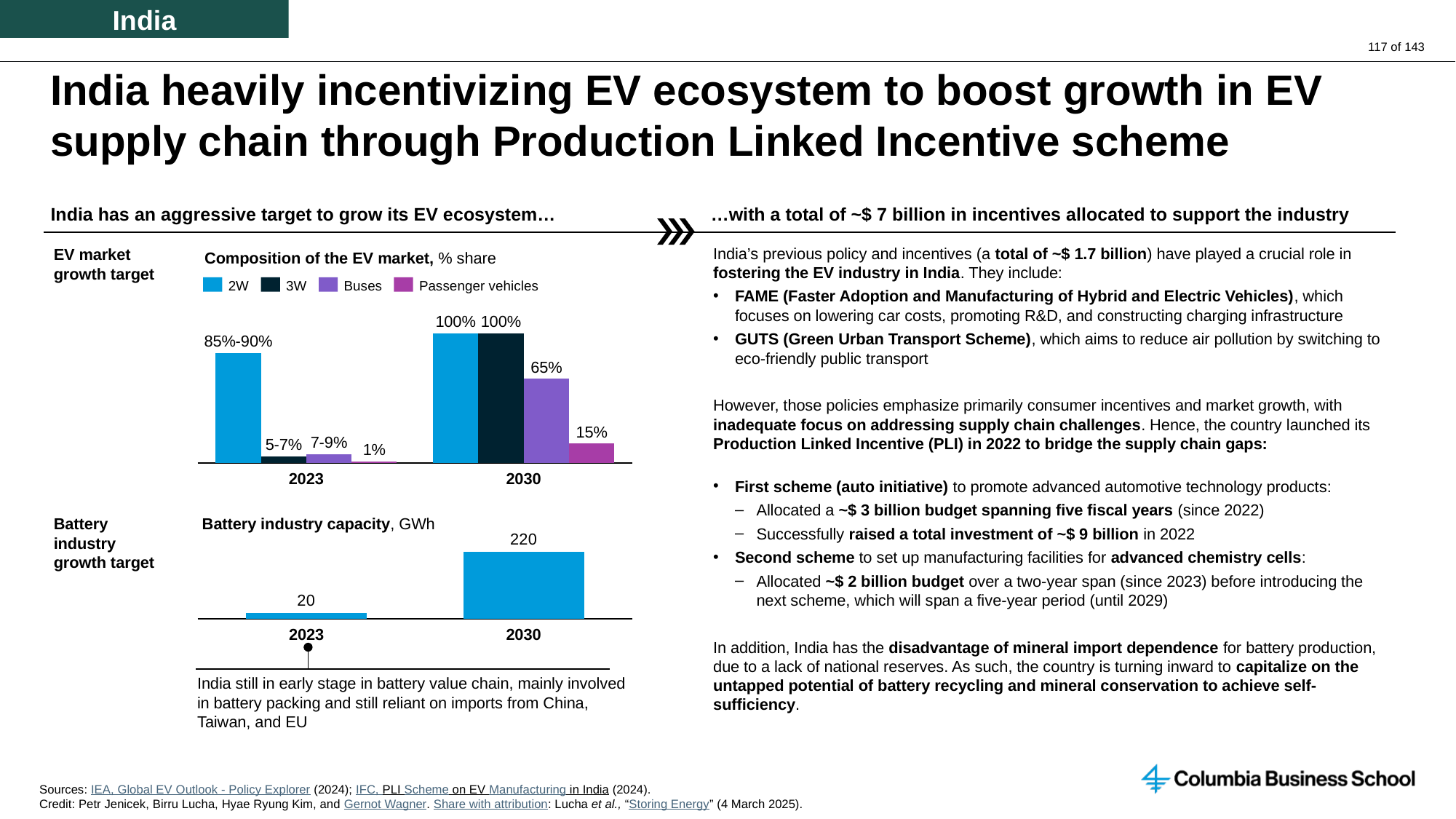
In the 'Composition of the EV market' chart, what is the value for Passenger vehicles in 2023? 1% In the 'Composition of the EV market' chart, what is the value for Buses in 2030? 65% In the 'Composition of the EV market' chart, what is the value for 2W in 2023? 85%-90% In the 'Composition of the EV market' chart, how many series does the legend list? 4 In the 'Composition of the EV market' chart, what is the value for 3W in 2030? 100% What kind of chart is the 'Battery industry capacity' chart? Bar chart In the 'Composition of the EV market' chart, is the value for Buses in 2030 larger than the value for Passenger vehicles in 2030? Yes In the 'Battery industry capacity' chart, what is the difference between the 2030 and 2023 values? 200 In the 'Battery industry capacity' chart, what unit is shown in the chart title? GWh In the 'Battery industry capacity' chart, what is the value for 2023? 20 In the 'Composition of the EV market' chart, which series has the lowest value in 2030? Passenger vehicles In the 'Battery industry capacity' chart, what is the value for 2030? 220